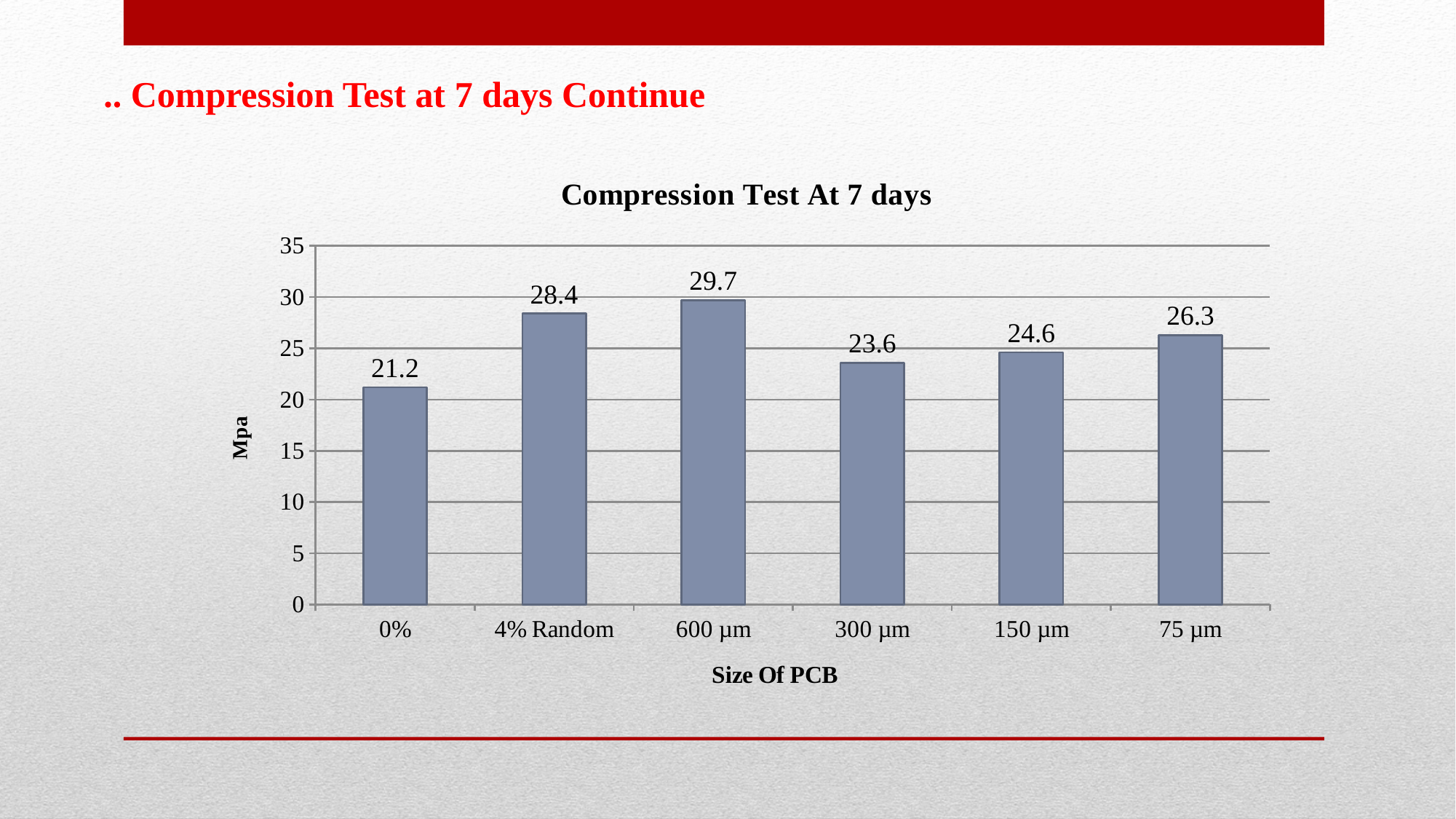
What is the label of the x axis? Size Of PCB What is the value shown for 150 µm? 24.6 Which category has the highest value? 600 µm Is the value for 4% Random greater or less than 25? greater What is the difference between the values for 600 µm and 0%? 8.5 What is the value shown for 600 µm? 29.7 What is the difference between the values for 4% Random and 75 µm? 2.1 How many categories are shown on the x axis? 6 Which is larger, the value for 300 µm or the value for 75 µm? 75 µm What is the compressive strength value for 0%? 21.2 Which category has the lowest value? 0% What kind of chart is shown on the slide? bar chart